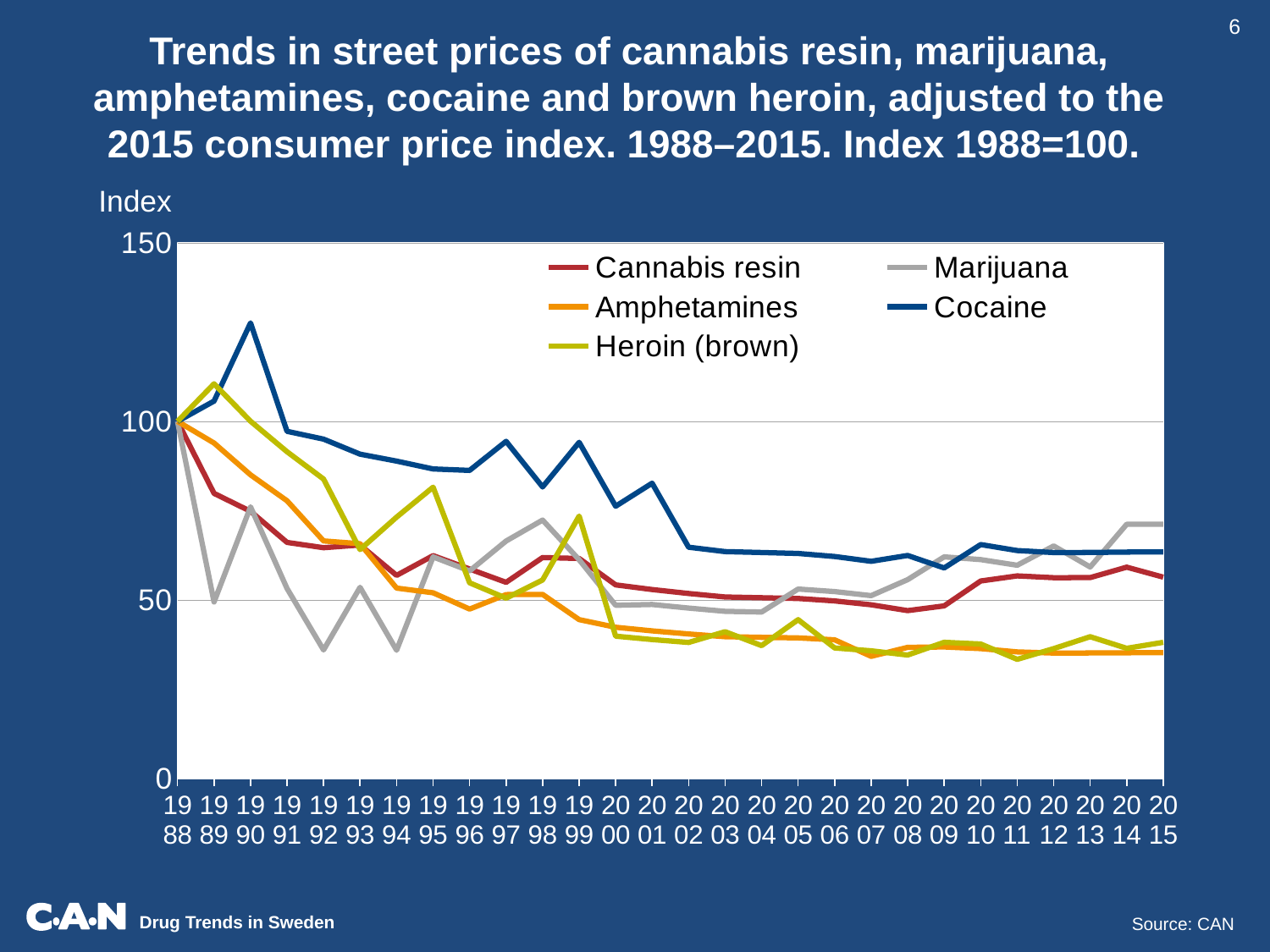
Which series has the lowest value in 1992? Marijuana What is the index value for Cocaine in 1988? 100 Which series has the highest value in 1990? Cocaine Is the value for Amphetamines in 2015 greater or less than 50? less Does the Cocaine line rise or fall overall from 1990 to 2015? Fall Is the value for Cocaine in 1990 greater or less than 100? greater Is the value for Marijuana in 2015 greater or less than 50? greater What label is shown on the vertical axis? Index In 2015, which is larger: the value for Marijuana or the value for Cannabis resin? Marijuana How many series does the legend list? 5 How many years are plotted along the x axis? 28 What kind of chart is shown on the slide? Line chart